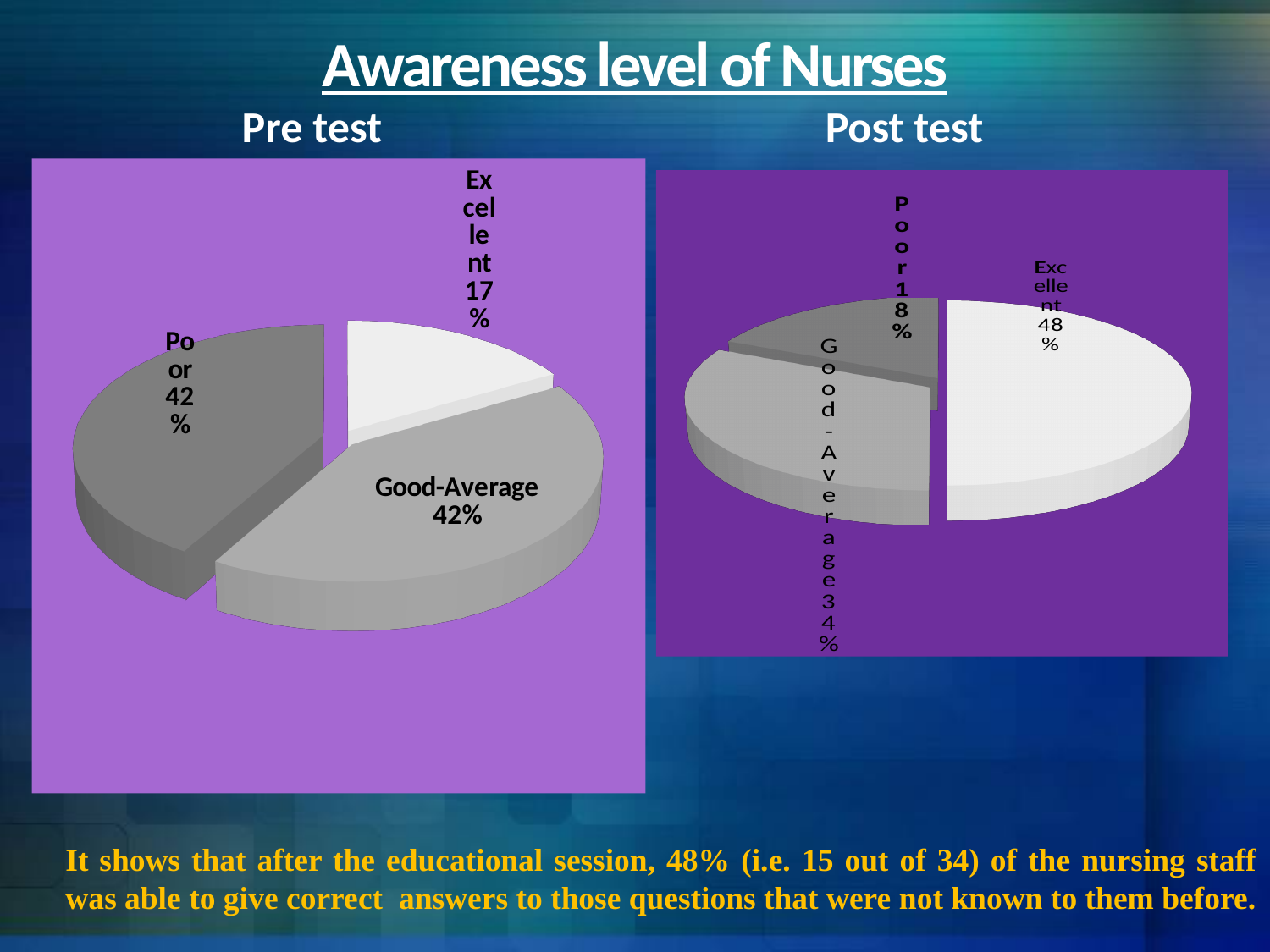
In the Post test chart, which category has the smallest slice? Poor What type of chart is used for the Post test? Pie chart In the Post test chart, what percentage is labelled Excellent? 48% In the Post test chart, what percentage is labelled Good-Average? 34% In the Pre test chart, which category has the smallest slice? Excellent In the Post test chart, which is larger: Good-Average or Poor? Good-Average How many slices does the Pre test pie chart have? 3 What is the difference between the Excellent percentage in the Post test chart and the Excellent percentage in the Pre test chart? 31% In the Pre test chart, what percentage is labelled Good-Average? 42% In the Post test chart, what percentage is labelled Poor? 18% In the Post test chart, which category has the largest slice? Excellent In the Pre test chart, what percentage is labelled Excellent? 17%